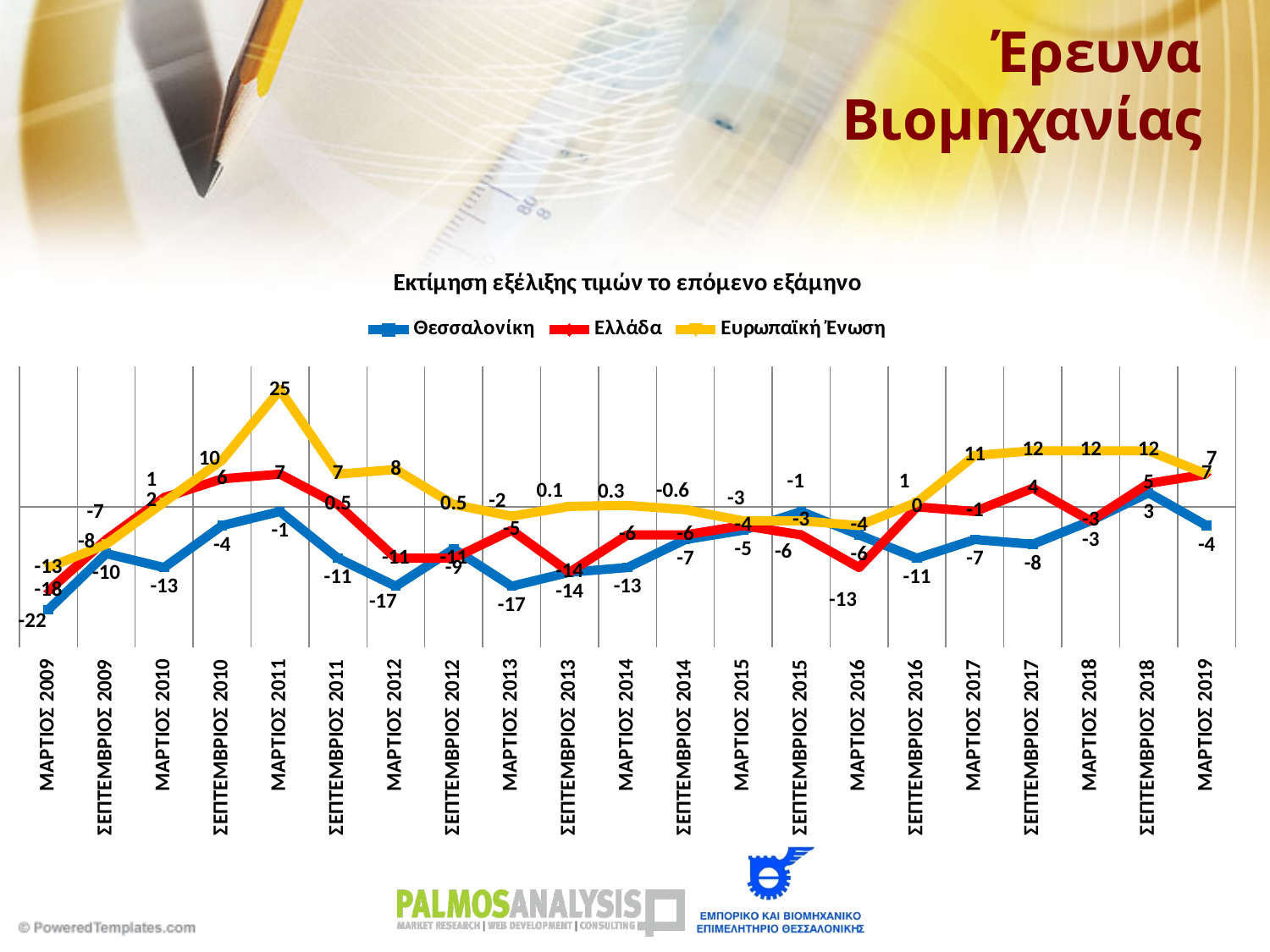
What is the title of the chart? Εκτίμηση εξέλιξης τιμών το επόμενο εξάμηνο Does the Θεσσαλονίκη series rise or fall from ΜΑΡΤΙΟΣ 2009 to ΜΑΡΤΙΟΣ 2011? Rise In which period does the Θεσσαλονίκη series have its lowest value? ΜΑΡΤΙΟΣ 2009 What is the value for Ελλάδα in ΜΑΡΤΙΟΣ 2019? 7 What kind of chart is shown on the slide? Line chart In ΜΑΡΤΙΟΣ 2019, which is larger: the value for Ελλάδα or for Θεσσαλονίκη? Ελλάδα What is the value for Θεσσαλονίκη in ΜΑΡΤΙΟΣ 2009? -22 How many series does the legend list? 3 How many time points are plotted along the x axis? 21 In which period does the Ευρωπαϊκή Ένωση series reach its highest value? ΜΑΡΤΙΟΣ 2011 What is the difference between the Ευρωπαϊκή Ένωση and Θεσσαλονίκη values in ΜΑΡΤΙΟΣ 2011? 26 What is the value for Ευρωπαϊκή Ένωση in ΜΑΡΤΙΟΣ 2011? 25